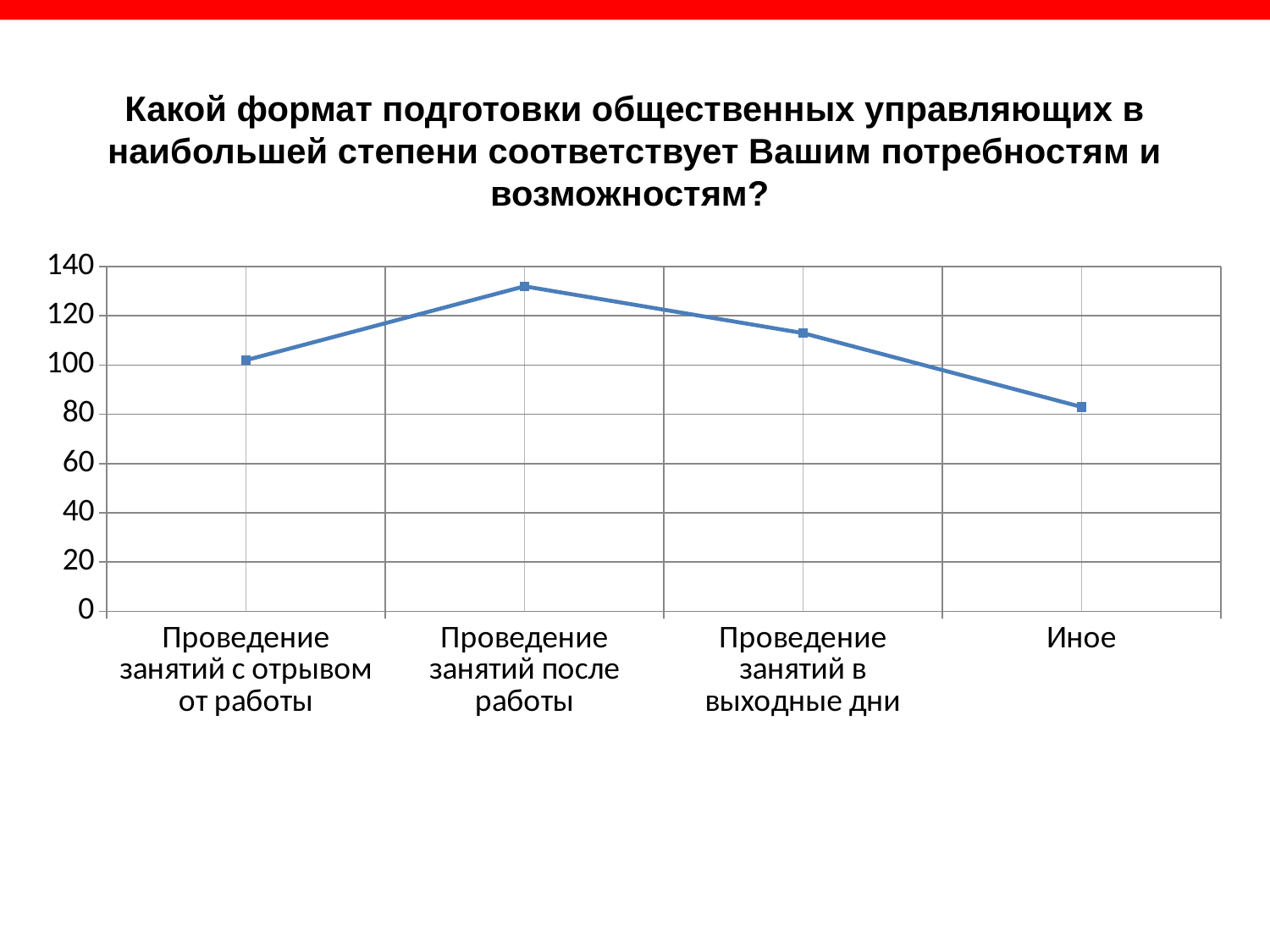
What kind of chart is shown on the slide? Line chart How does the line move from the first category to the last along the x axis? It rises to the second category, then falls Which category has the highest value in the chart? Проведение занятий после работы What is the maximum value shown on the vertical axis of the chart? 140 Is the value for "Проведение занятий в выходные дни" greater or less than 100? greater Is the value for "Проведение занятий с отрывом от работы" greater or less than 120? less How many categories are plotted on the x axis of the chart? 4 Which is larger: the value for "Проведение занятий в выходные дни" or the value for "Проведение занятий с отрывом от работы"? Проведение занятий в выходные дни Is the value for "Иное" greater or less than 100? less Which category has the lowest value in the chart? Иное Which is larger: the value for "Проведение занятий после работы" or the value for "Иное"? Проведение занятий после работы